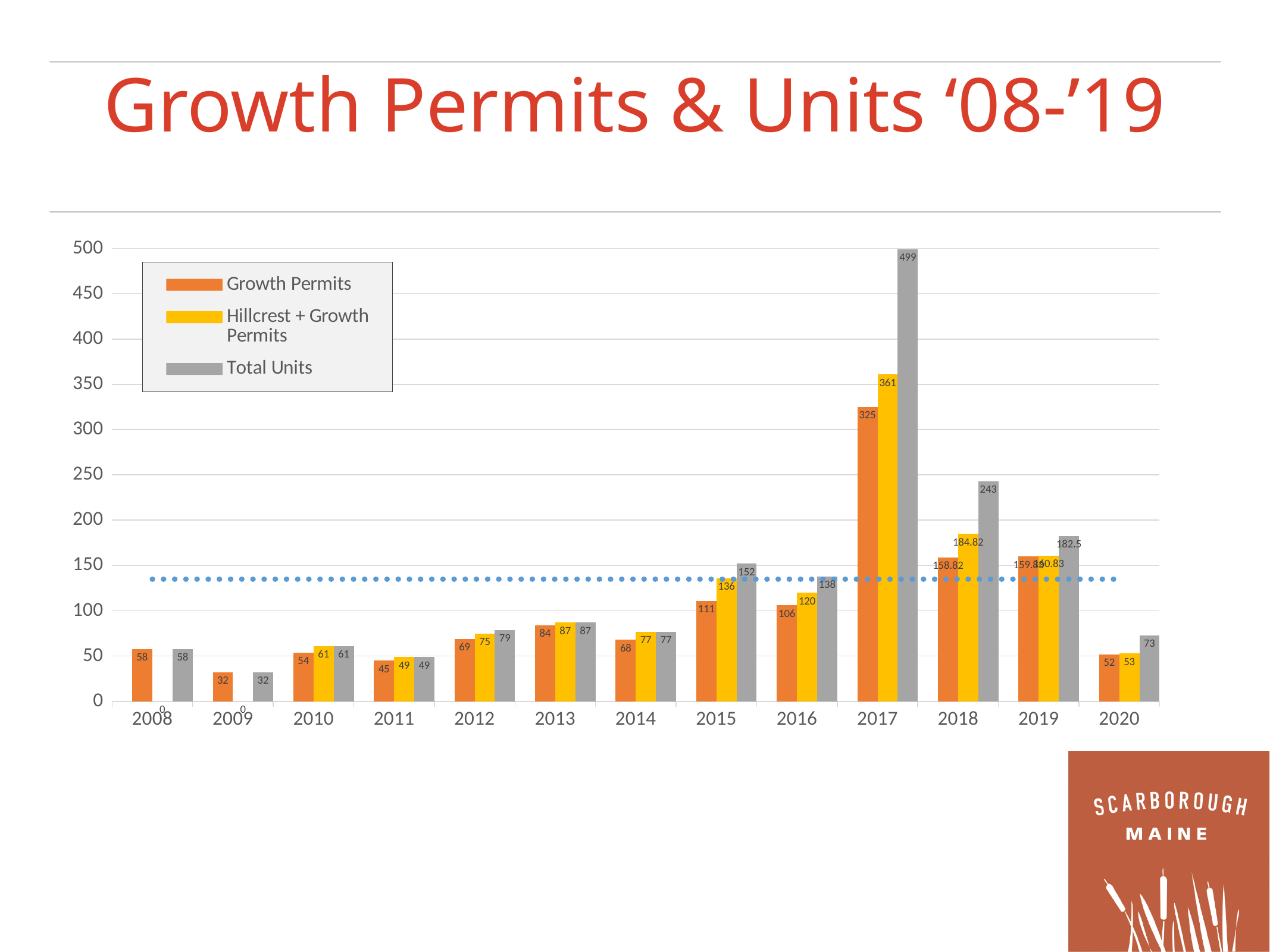
How many series does the legend list? 3 Which year has the larger Total Units value, 2015 or 2016? 2015 What is the Hillcrest + Growth Permits value for 2015? 136 Which year has the highest Total Units value? 2017 Which series is shown in gray in the legend? Total Units What is the Growth Permits value for 2018? 158.82 What is the difference between Total Units and Hillcrest + Growth Permits in 2017? 138 What is the Total Units value for 2017? 499 What is the Total Units value for 2020? 73 How many years are shown on the x axis? 13 Which year has the lowest Growth Permits value? 2009 What kind of chart is shown on the slide? bar chart